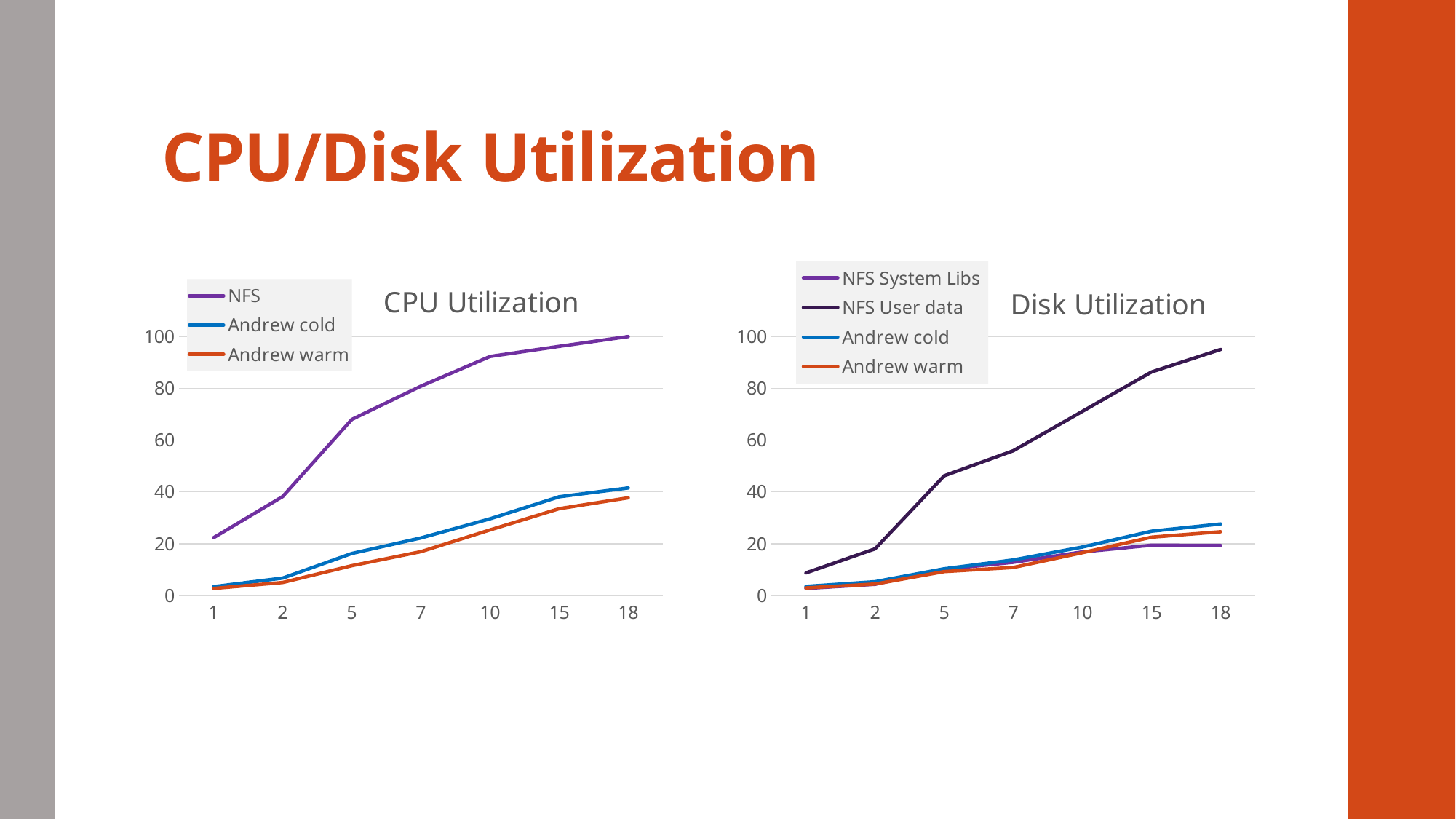
How many series does the legend of the Disk Utilization chart list? 4 In the Disk Utilization chart, which series has the highest value at x = 18? NFS User data How many points are plotted along the x axis of the CPU Utilization chart? 7 In the CPU Utilization chart, which series has the highest value at x = 18? NFS What is the title of the chart on the right side of the slide? Disk Utilization In the Disk Utilization chart, is the value for NFS User data at x = 5 greater or less than 40? greater What kind of chart is the CPU Utilization chart? line chart How many series does the legend of the CPU Utilization chart list? 3 In the Disk Utilization chart, is the value for NFS System Libs at x = 18 greater or less than 40? less In the CPU Utilization chart, which is larger at x = 5: NFS or Andrew cold? NFS In the CPU Utilization chart, does the NFS series rise or fall as x increases from 1 to 18? rise In the CPU Utilization chart, is the value for NFS at x = 5 greater or less than 60? greater